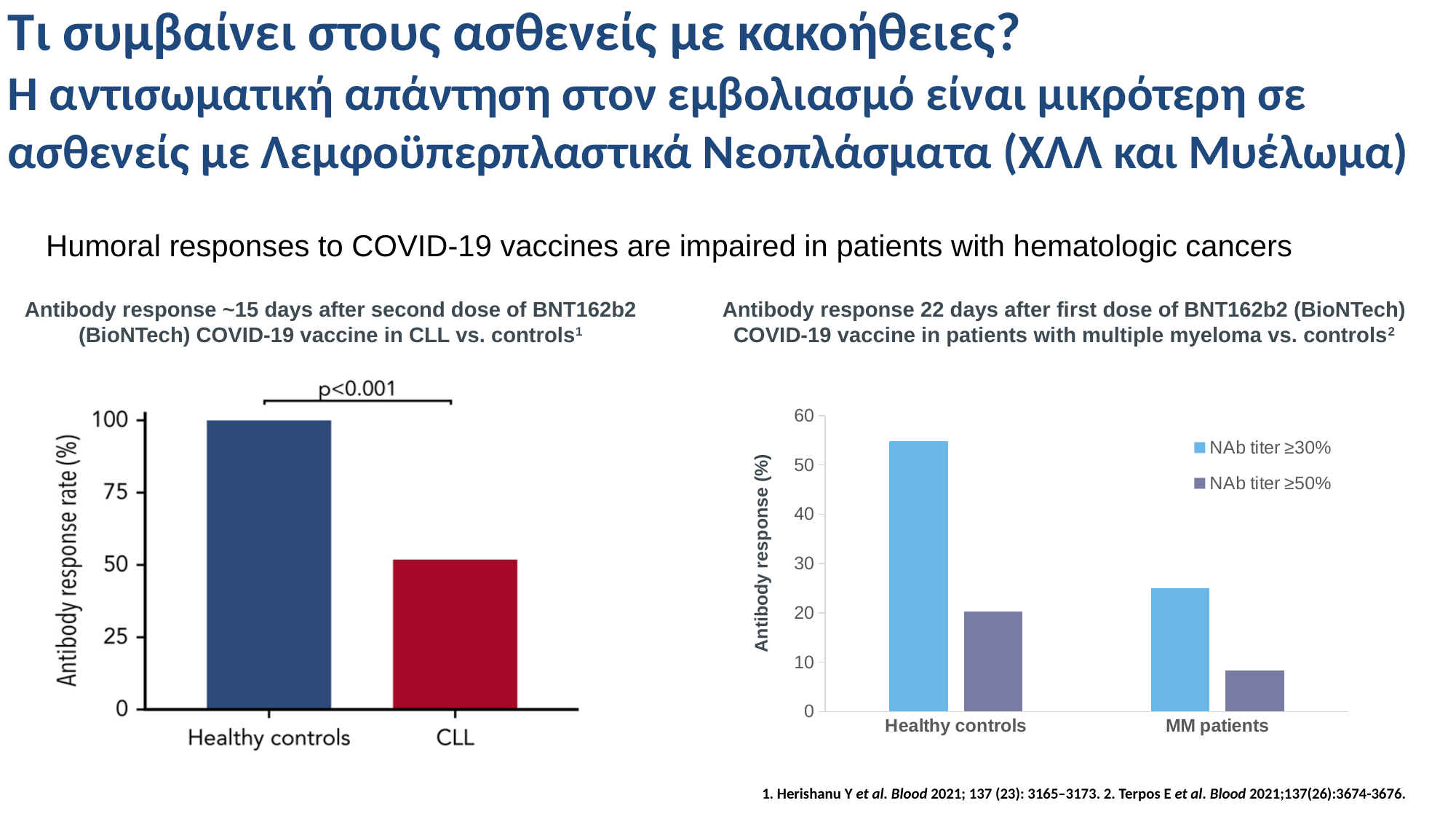
In the left chart (CLL vs. controls), which category has the lower antibody response rate? CLL In the left chart (CLL vs. controls), what p-value is shown above the bars? p<0.001 In the left chart (CLL vs. controls), what is the antibody response rate for Healthy controls? 100 In the left chart (CLL vs. controls), how many categories are shown on the x axis? 2 In the right chart (multiple myeloma vs. controls), what is the label of the y axis? Antibody response (%) In the right chart (multiple myeloma vs. controls), is the NAb titer ≥30% value for MM patients greater or less than 30? less In the right chart (multiple myeloma vs. controls), which group has the higher NAb titer ≥30% response, Healthy controls or MM patients? Healthy controls In the right chart (multiple myeloma vs. controls), how many series does the legend list? 2 In the right chart (multiple myeloma vs. controls), is the NAb titer ≥50% value for MM patients greater or less than 10? less In the left chart (CLL vs. controls), is the antibody response rate for CLL greater or less than 75? less In the left chart (CLL vs. controls), what type of chart is shown? bar chart